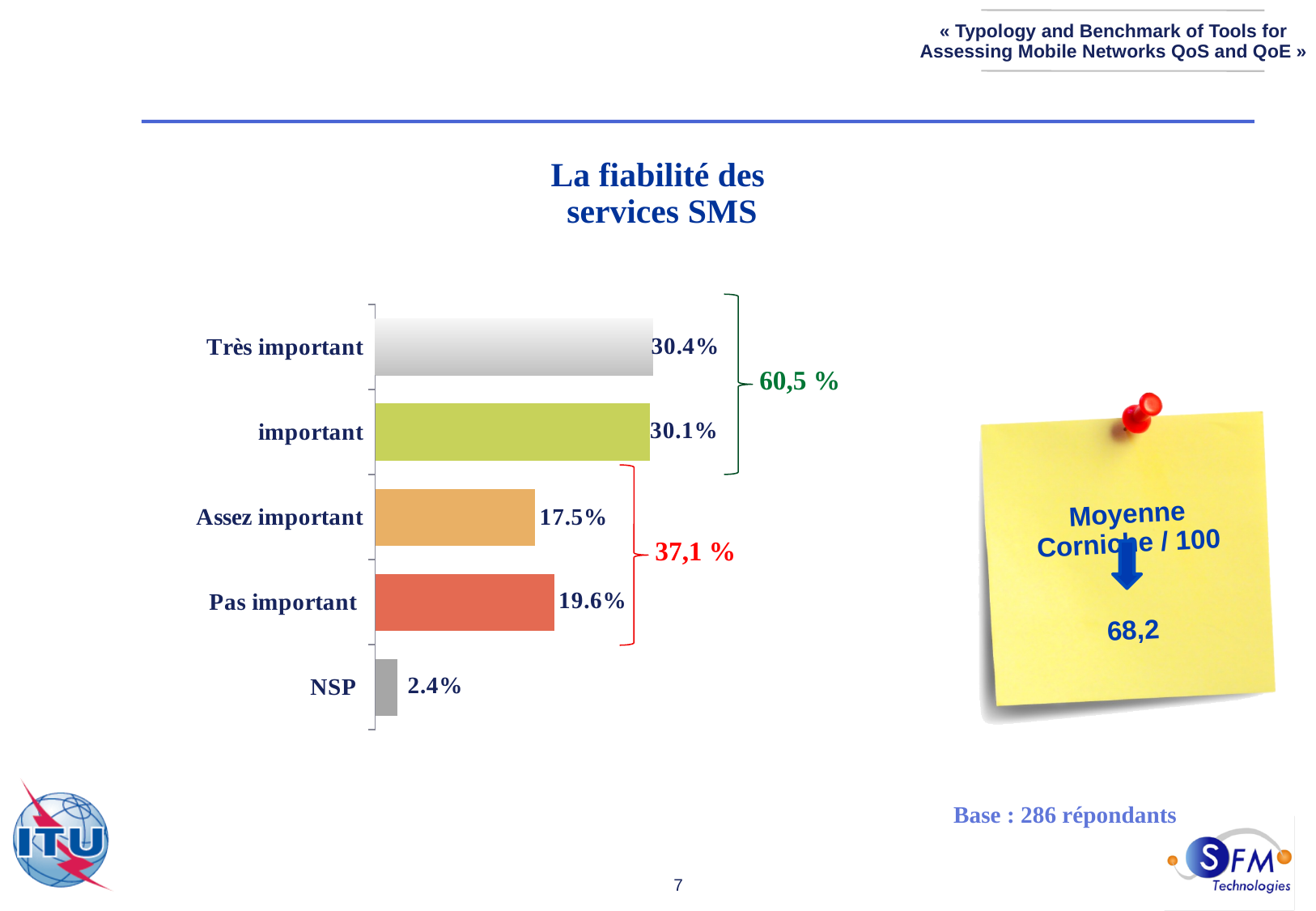
What is the value for "Pas important"? 19.6% What is the value for "NSP"? 2.4% What is the title of the chart? La fiabilité des services SMS What is the difference between the values for "Pas important" and "Assez important"? 2.1% Which category has the highest value? Très important What combined percentage is shown by the green bracket grouping "Très important" and "important"? 60,5 % What kind of chart is shown on the slide? Bar chart Which category has the lowest value? NSP Which is larger, the value for "Pas important" or the value for "Assez important"? Pas important What is the value for "Assez important"? 17.5% How many categories are shown in the chart? 5 What is the value for "Très important"? 30.4%